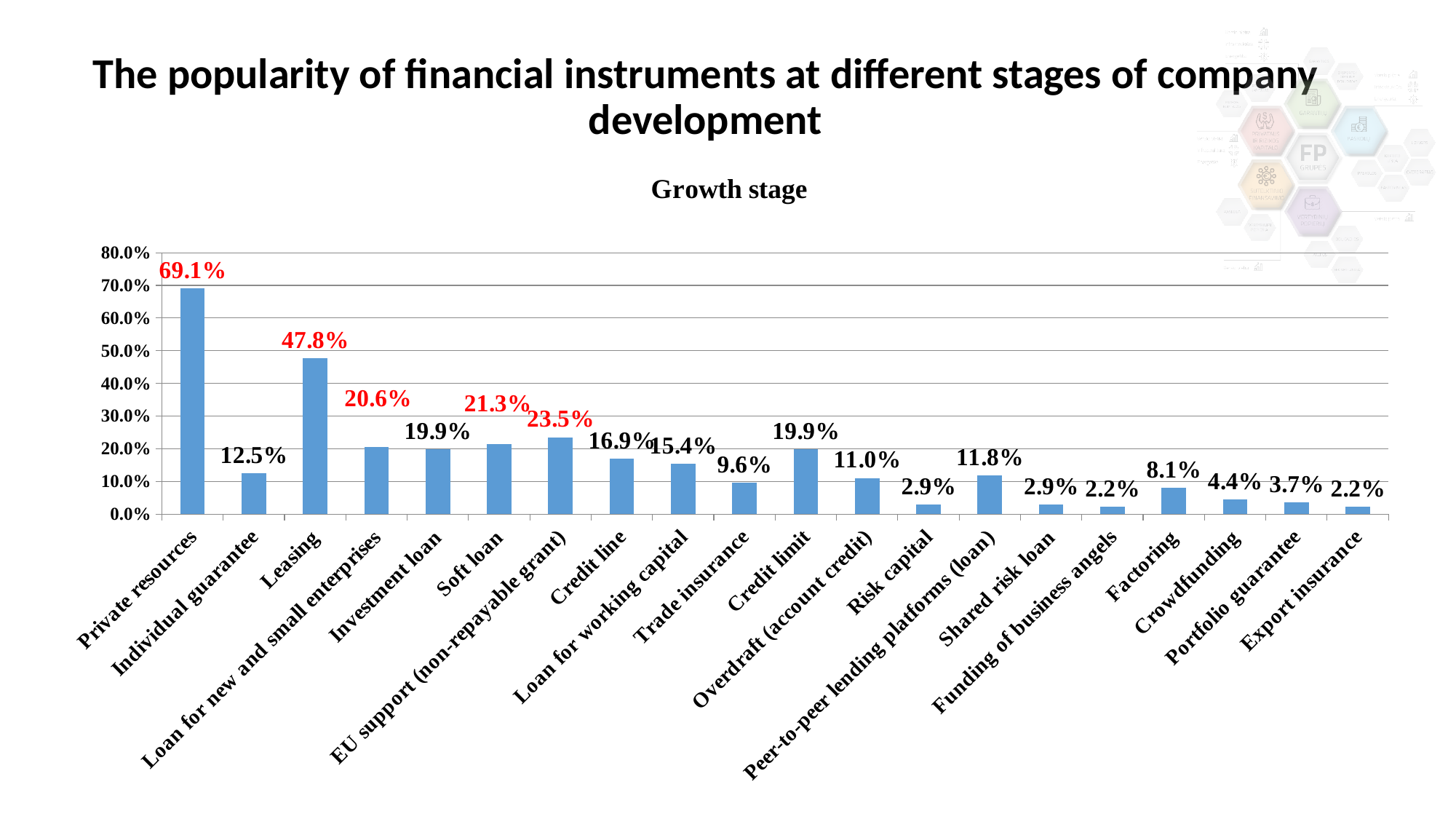
What is the difference between the values for Private resources and Leasing? 21.3% What is the value for Leasing? 47.8% What is the value for Factoring? 8.1% What is the value for EU support (non-repayable grant)? 23.5% Which is larger, the value for Leasing or the value for EU support (non-repayable grant)? Leasing How many categories are shown on the x axis? 20 Is the value for Trade insurance greater or less than 10.0%? less What is the title of the chart? Growth stage What is the difference between the values for EU support (non-repayable grant) and Credit line? 6.6% What kind of chart is shown on the slide? bar chart Which category has the highest value? Private resources What is the value for Private resources? 69.1%